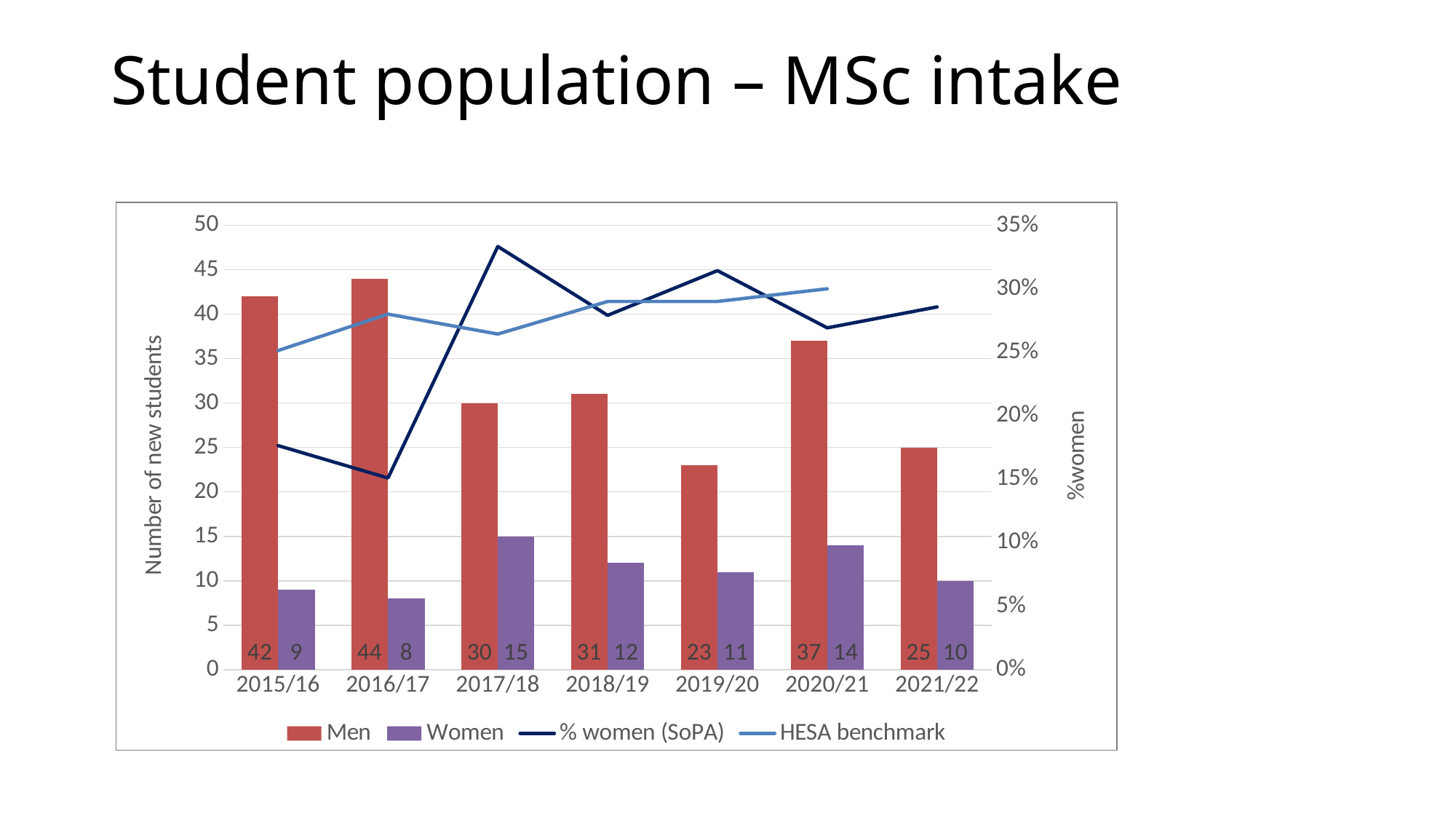
How many series does the legend list? 4 Which year had the highest number of new men students? 2016/17 How many new men students were there in 2016/17? 44 What is the difference between the number of men and women new students in 2020/21? 23 How many new women students were there in 2017/18? 15 What is the label of the right-hand vertical axis? %women Is the HESA benchmark value for 2015/16 greater or less than 30%? less Which year had more new women students, 2018/19 or 2019/20? 2018/19 How many academic years are shown on the x axis? 7 Is the % women (SoPA) value for 2017/18 greater or less than 30%? greater How many new men students were there in 2021/22? 25 Which year had the lowest number of new women students? 2016/17